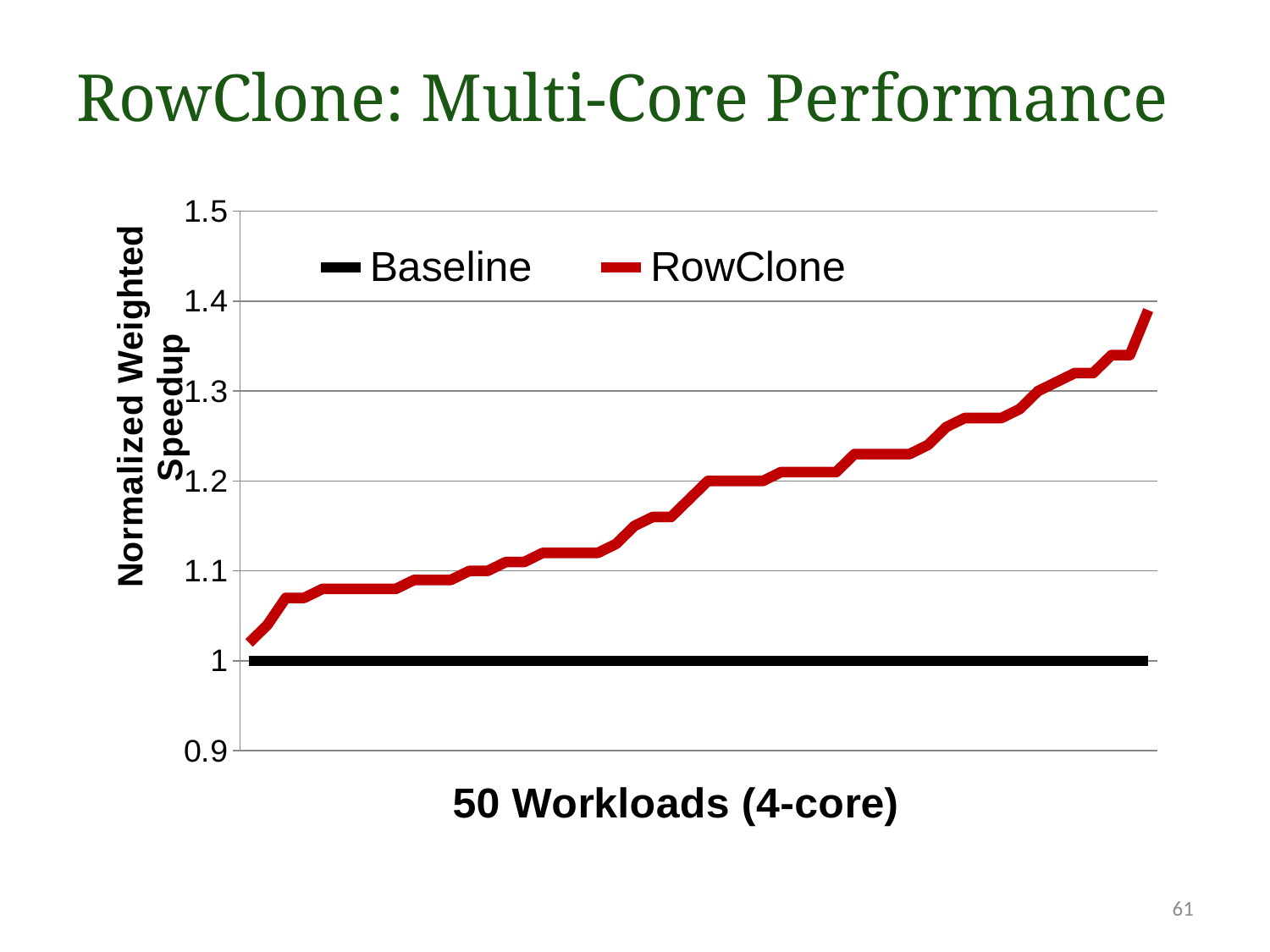
Does the RowClone series rise or fall from left to right along the x axis? rise Is the highest RowClone value greater or less than 1.3? greater Which series is higher across the workloads, RowClone or Baseline? RowClone How many workloads are plotted according to the x-axis label? 50 What kind of chart is shown on the slide? line chart What value does the Baseline series hold across all workloads? 1 Is the highest RowClone value greater or less than 1.4? less Is the RowClone value for the rightmost workload greater or less than 1.2? greater What is the label of the y axis? Normalized Weighted Speedup How many series does the legend list? 2 What are the two series named in the legend? Baseline and RowClone